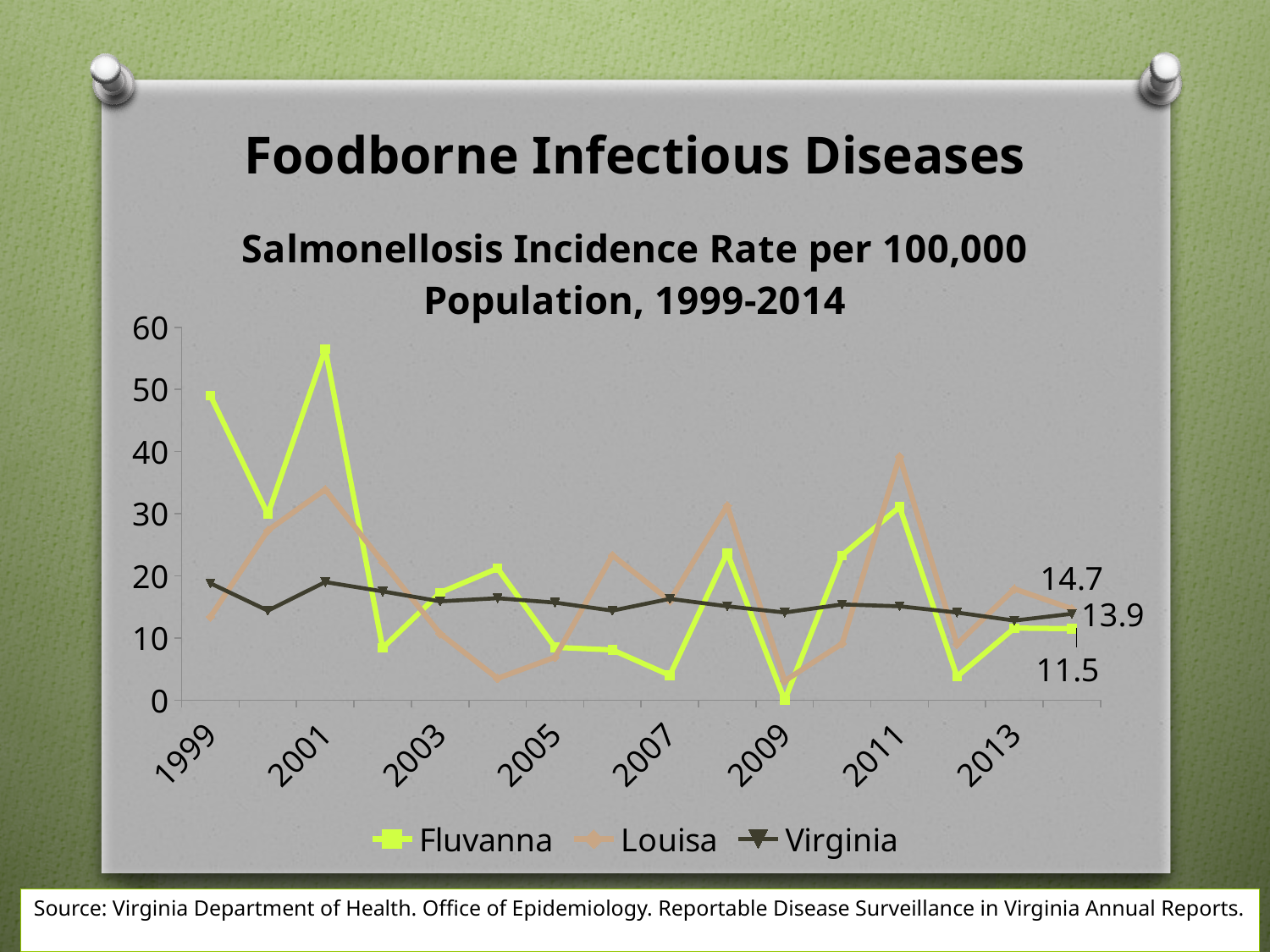
Is the Fluvanna value for 2001 greater or less than 50? greater How many series does the legend list? 3 What is the difference between the Louisa and Fluvanna rates in 2014? 3.2 Is the Fluvanna value for 2009 greater or less than 10? less What is the Fluvanna salmonellosis incidence rate in 2014? 11.5 In 2014, which is higher: the Louisa rate or the Virginia rate? Louisa What kind of chart is shown on the slide? line chart What is the difference between the Virginia and Fluvanna rates in 2014? 2.4 What is the Louisa salmonellosis incidence rate in 2014? 14.7 In which year does the Fluvanna line reach its highest value? 2001 In which year does the Fluvanna line reach its lowest value? 2009 What is the Virginia salmonellosis incidence rate in 2014? 13.9